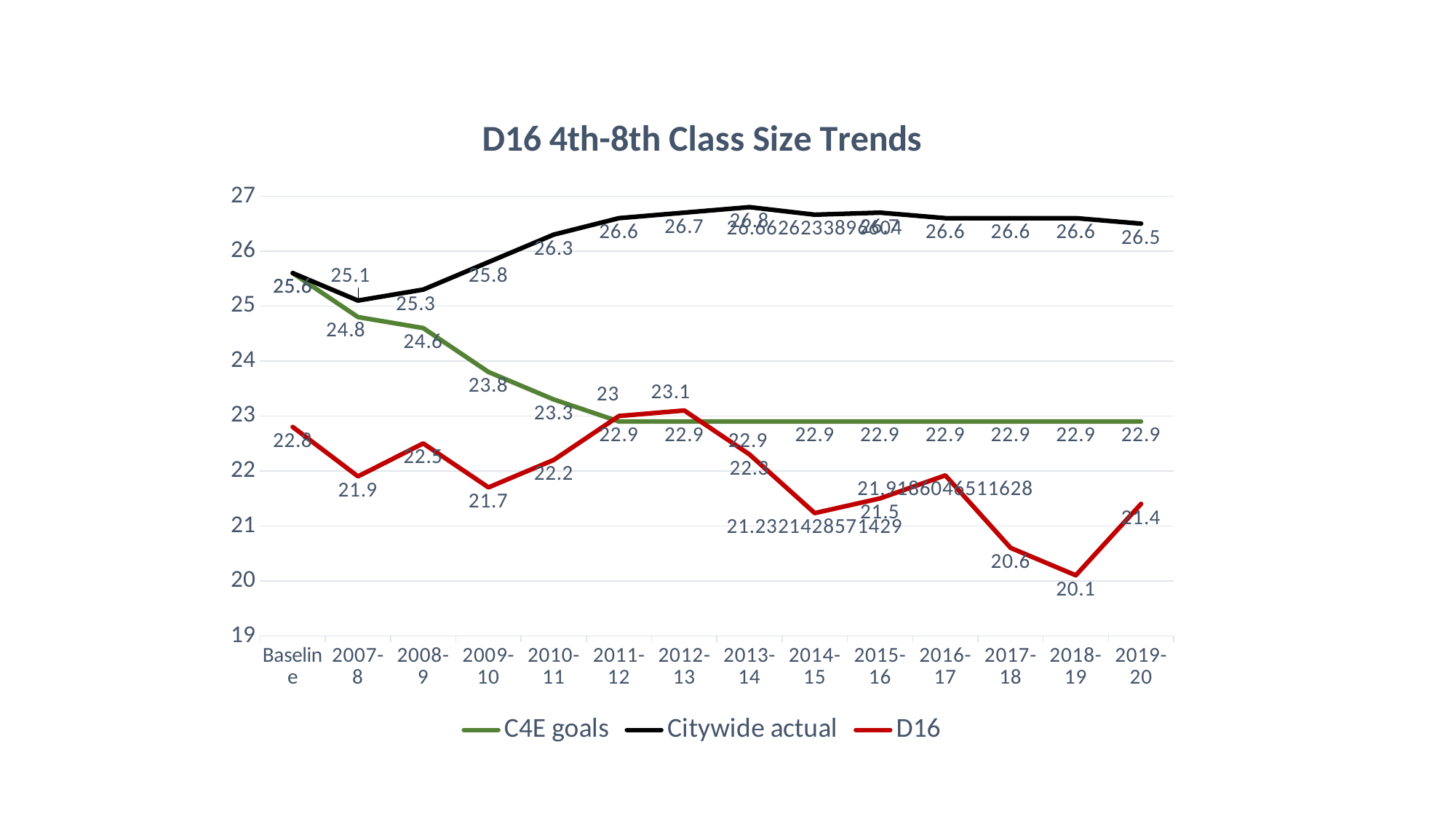
What is the D16 value for 2018-19? 20.1 In which year is the D16 value highest? 2012-13 What is the C4E goals value for 2009-10? 23.8 In which year is the D16 value lowest? 2018-19 What is the Citywide actual value for 2019-20? 26.5 How many series does the legend list? 3 Is the Citywide actual value for 2012-13 greater or less than 26? greater Do the C4E goals values rise or fall from Baseline to 2011-12? fall What kind of chart is shown on the slide? line chart How many categories are shown on the x axis? 14 For 2017-18, which is larger: the C4E goals value or the D16 value? C4E goals What is the difference between the Citywide actual and D16 values for 2019-20? 5.1